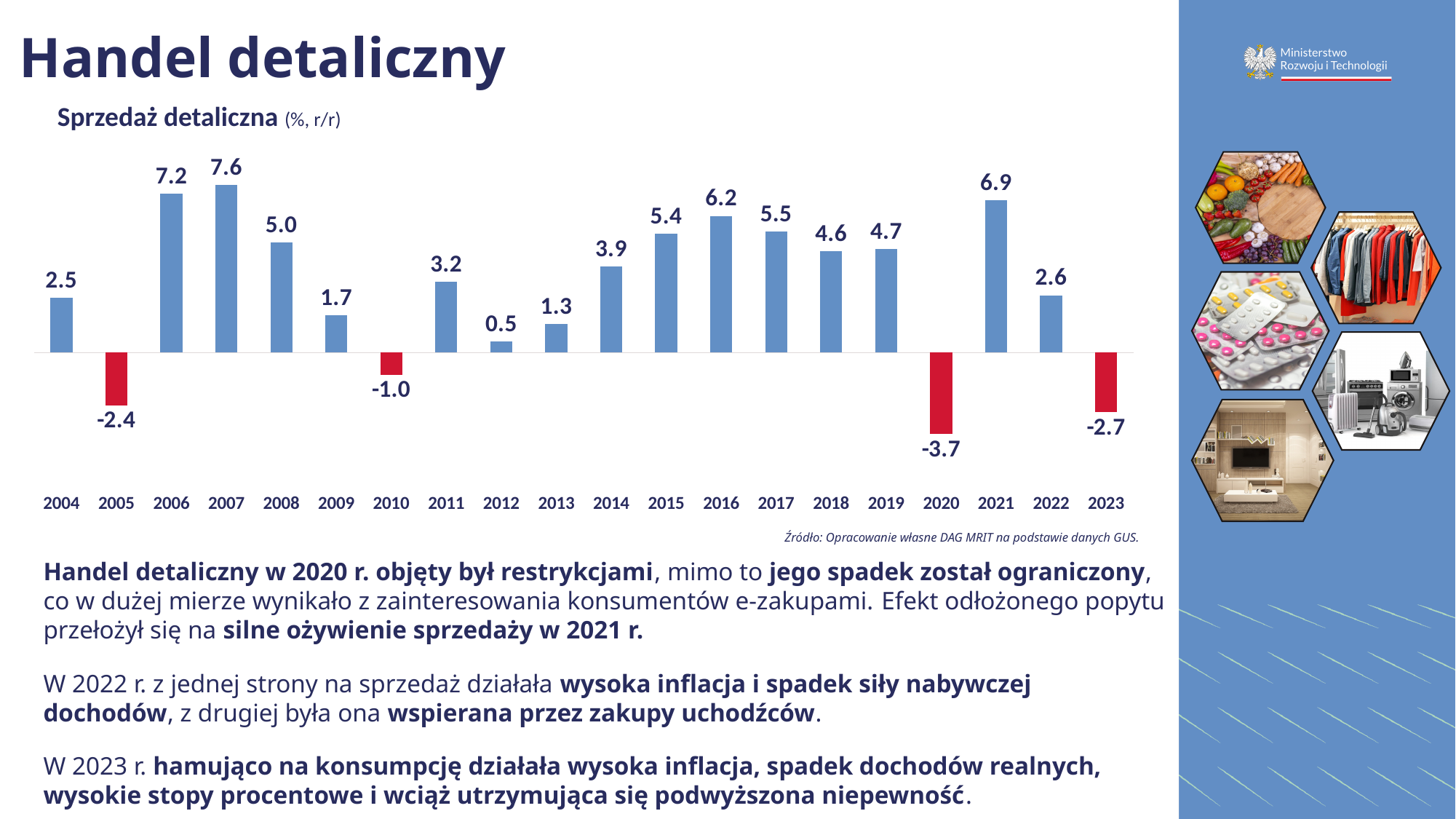
Which year has the highest value? 2007 How many years have a negative value? 4 Do the values rise or fall from 2011 to 2016? rise What kind of chart is this? bar chart What is the value for 2020? -3.7 What is the difference between the values for 2021 and 2022? 4.3 What is the value for 2023? -2.7 What is the value for 2007? 7.6 Which year has the lowest value? 2020 How many years are shown on the x axis? 20 What is the title of the chart? Sprzedaż detaliczna (%, r/r) Which is larger, the value for 2016 or the value for 2017? 2016